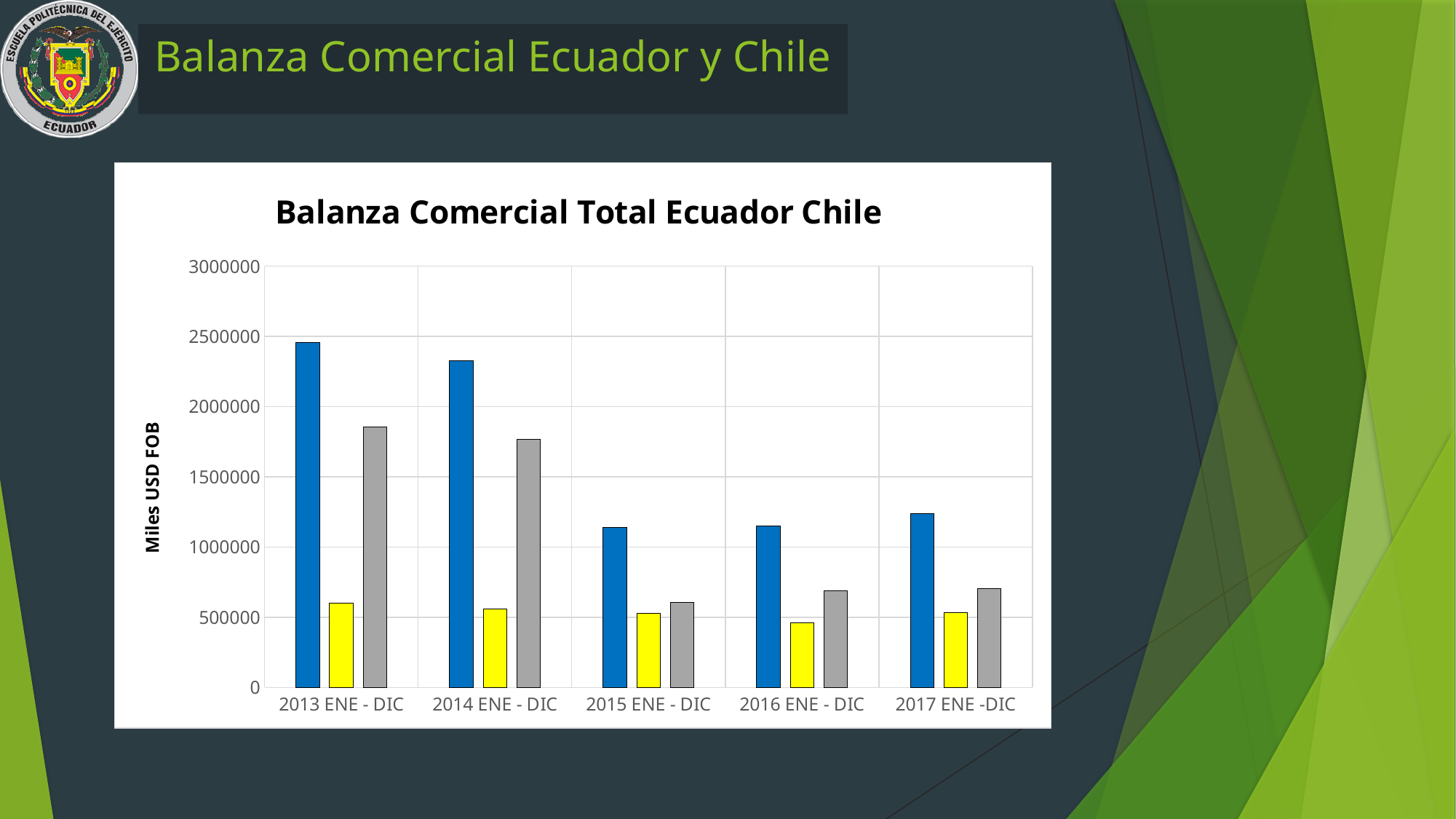
What kind of chart is shown on the slide? bar chart What is the title of the chart? Balanza Comercial Total Ecuador Chile Which year has the lowest yellow bar? 2016 ENE - DIC How many bars are plotted for each year category? 3 How many year categories are shown on the x axis? 5 Is the value of the yellow bar for 2013 ENE - DIC greater or less than 500000? greater Which year has the highest blue bar? 2013 ENE - DIC Is the value of the blue bar for 2013 ENE - DIC greater or less than 2000000? greater Is the value of the blue bar for 2015 ENE - DIC greater or less than 1000000? greater Which is larger, the blue bar for 2013 ENE - DIC or the blue bar for 2014 ENE - DIC? 2013 ENE - DIC What is the label on the vertical axis of the chart? Miles USD FOB